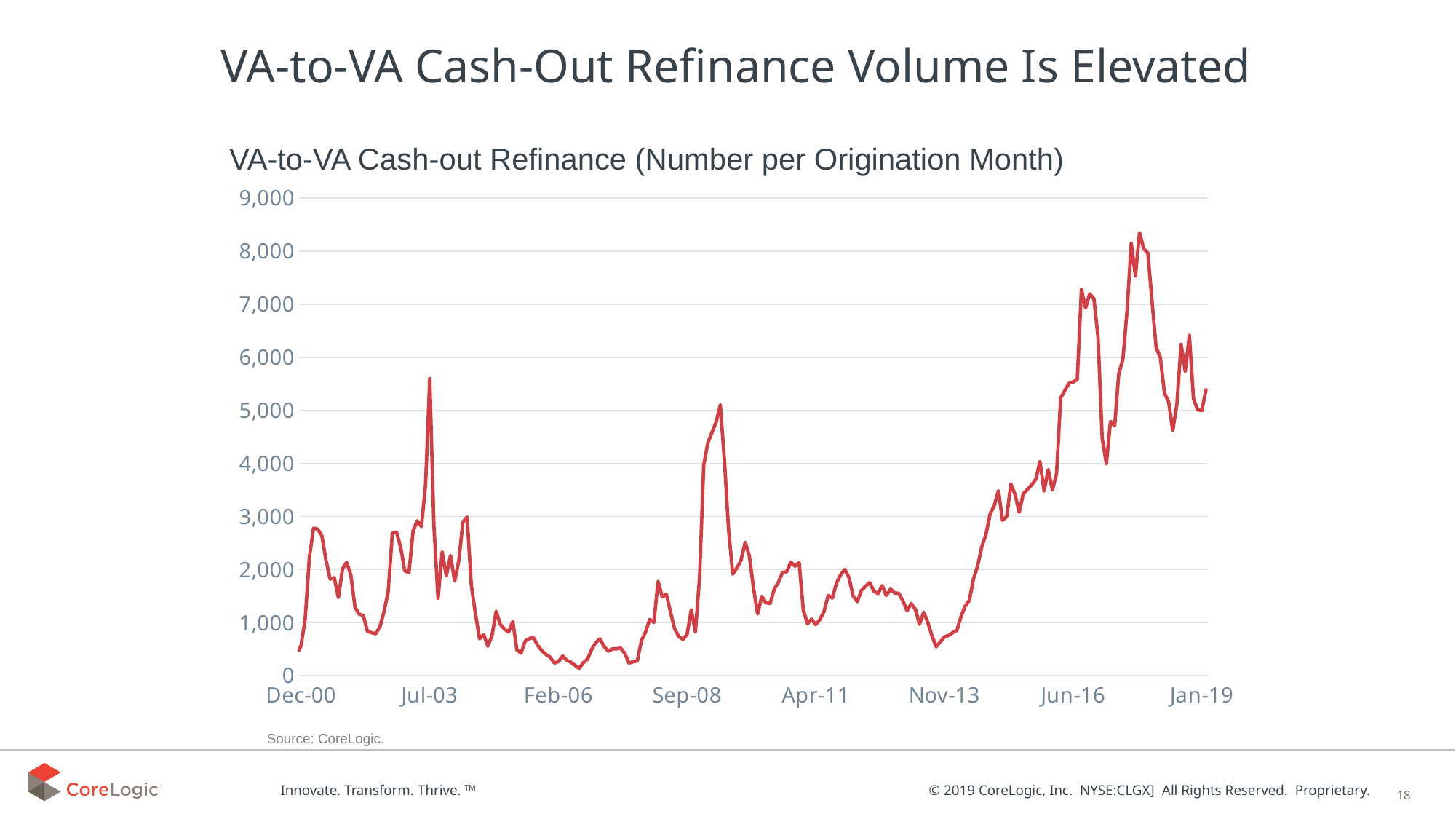
Is the value at Nov-13 greater or less than 1,000? less What is the first date label on the x axis? Dec-00 What is the highest value shown on the y axis? 9,000 What is the last date label on the x axis? Jan-19 What is the title of the chart? VA-to-VA Cash-out Refinance (Number per Origination Month) Is the value at Dec-00 greater or less than 1,000? less Does the line generally rise or fall between Nov-13 and Jun-16? rise Is the value at Jun-16 greater or less than 3,000? greater What kind of chart is shown on the slide? line chart What colour is the line plotted on the chart? red How many date labels are shown on the x axis? 8